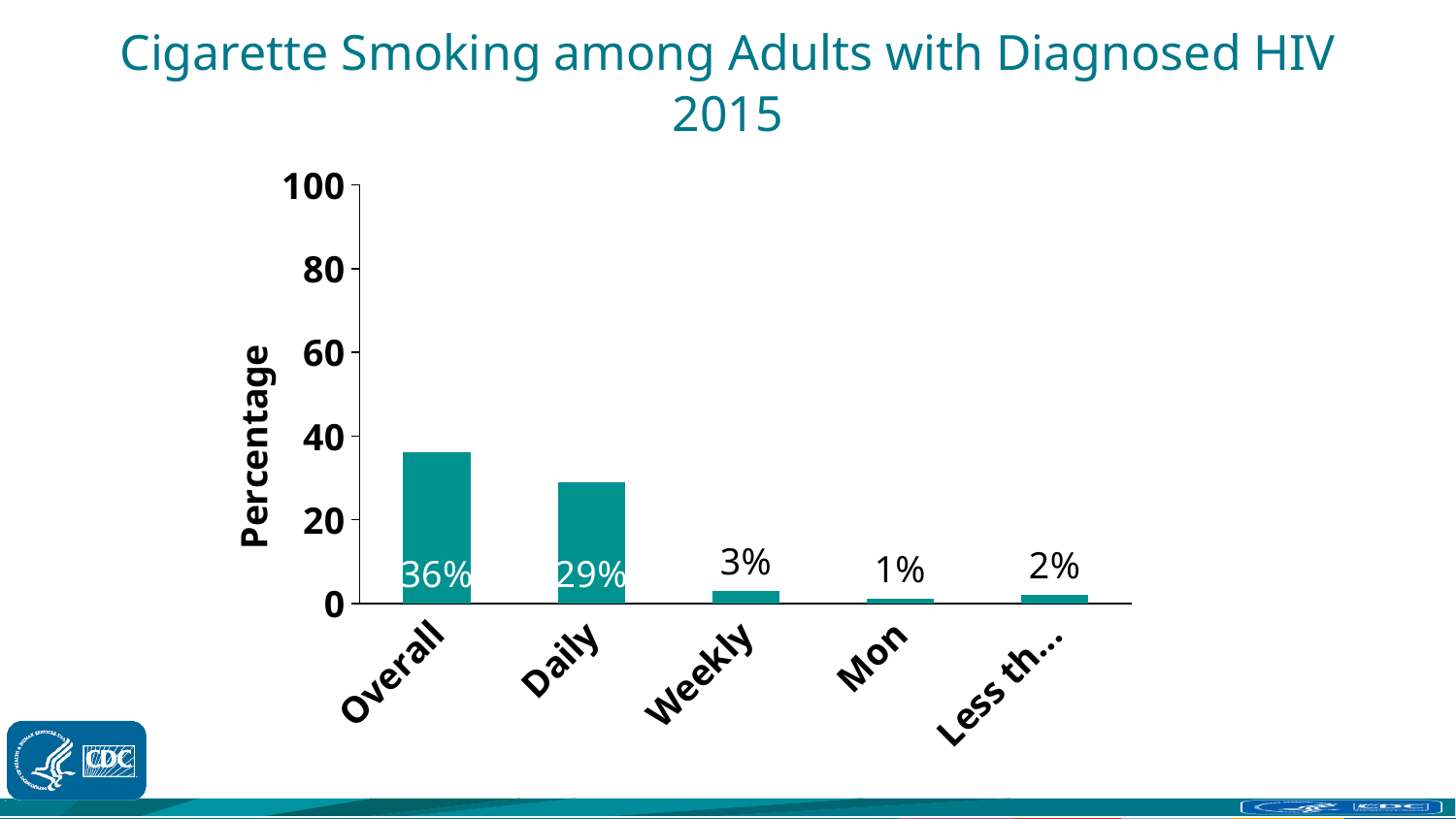
What is the value for Weekly? 3% What type of chart is shown on the slide? Bar chart What is the value for Overall? 36% Which category has the lowest value? Mon How many bars are shown in the chart? 5 Which category has the highest value? Overall Is the value for Overall greater or less than 40? less What is the value shown on the fourth bar, labelled "Mon"? 1% What is the difference between the Overall and Daily values? 7% What is the value shown on the last bar, labelled "Less th…"? 2% What is the value for Daily? 29% Which is larger, the value for Daily or the value for Weekly? Daily